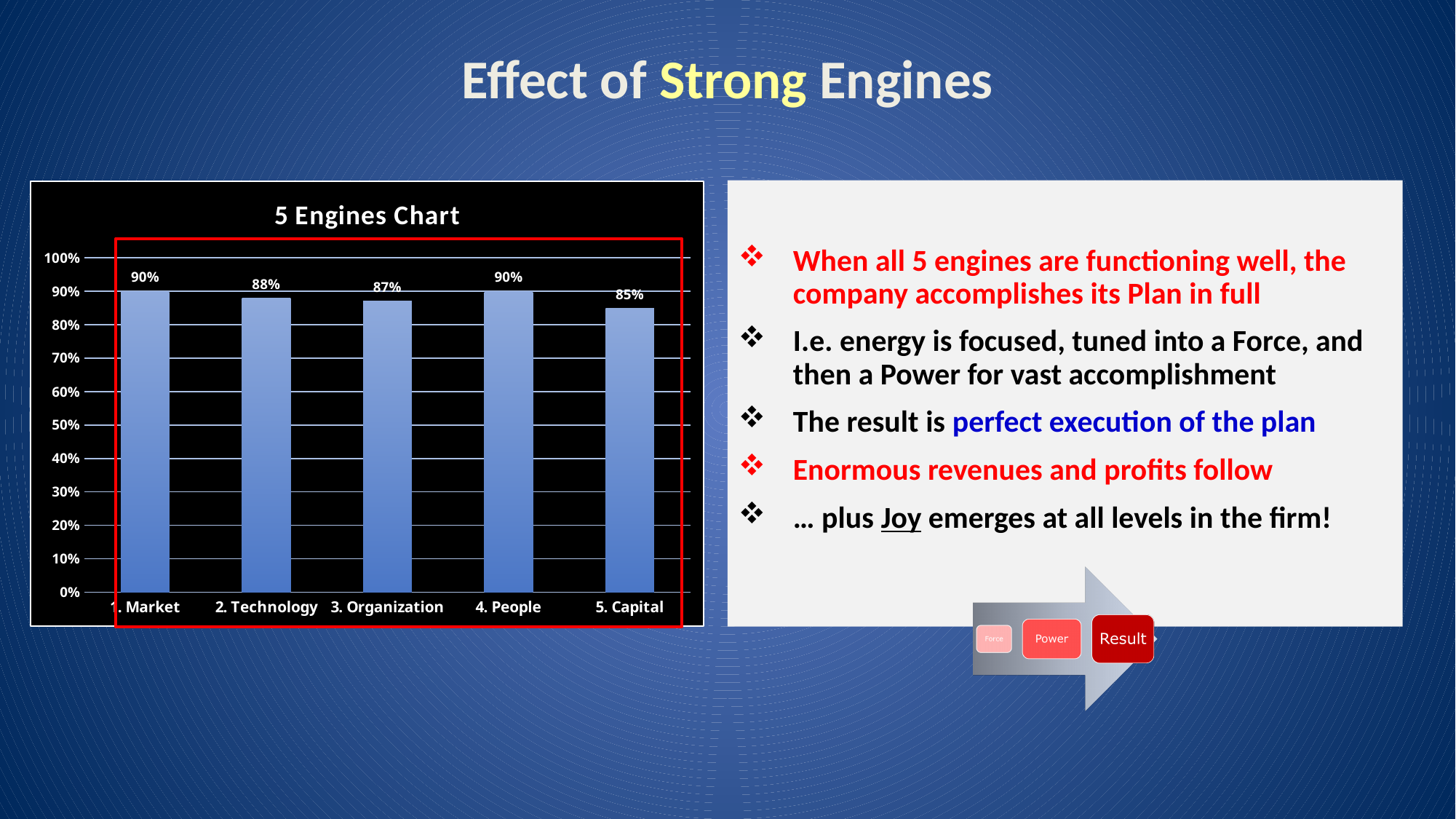
Which category has the lowest value in the 5 Engines Chart? 5. Capital What is the difference between the values for 1. Market and 5. Capital in the 5 Engines Chart? 5% What is the value for 1. Market in the 5 Engines Chart? 90% What kind of chart is the 5 Engines Chart? Bar chart How many categories are shown in the 5 Engines Chart? 5 What is the value for 2. Technology in the 5 Engines Chart? 88% What is the difference between the values for 2. Technology and 3. Organization in the 5 Engines Chart? 1% Is the value for 4. People in the 5 Engines Chart greater or less than 80%? greater What is the title of the chart on the slide? 5 Engines Chart Which is larger in the 5 Engines Chart, the value for 2. Technology or the value for 5. Capital? 2. Technology What is the value for 3. Organization in the 5 Engines Chart? 87% What is the value for 5. Capital in the 5 Engines Chart? 85%